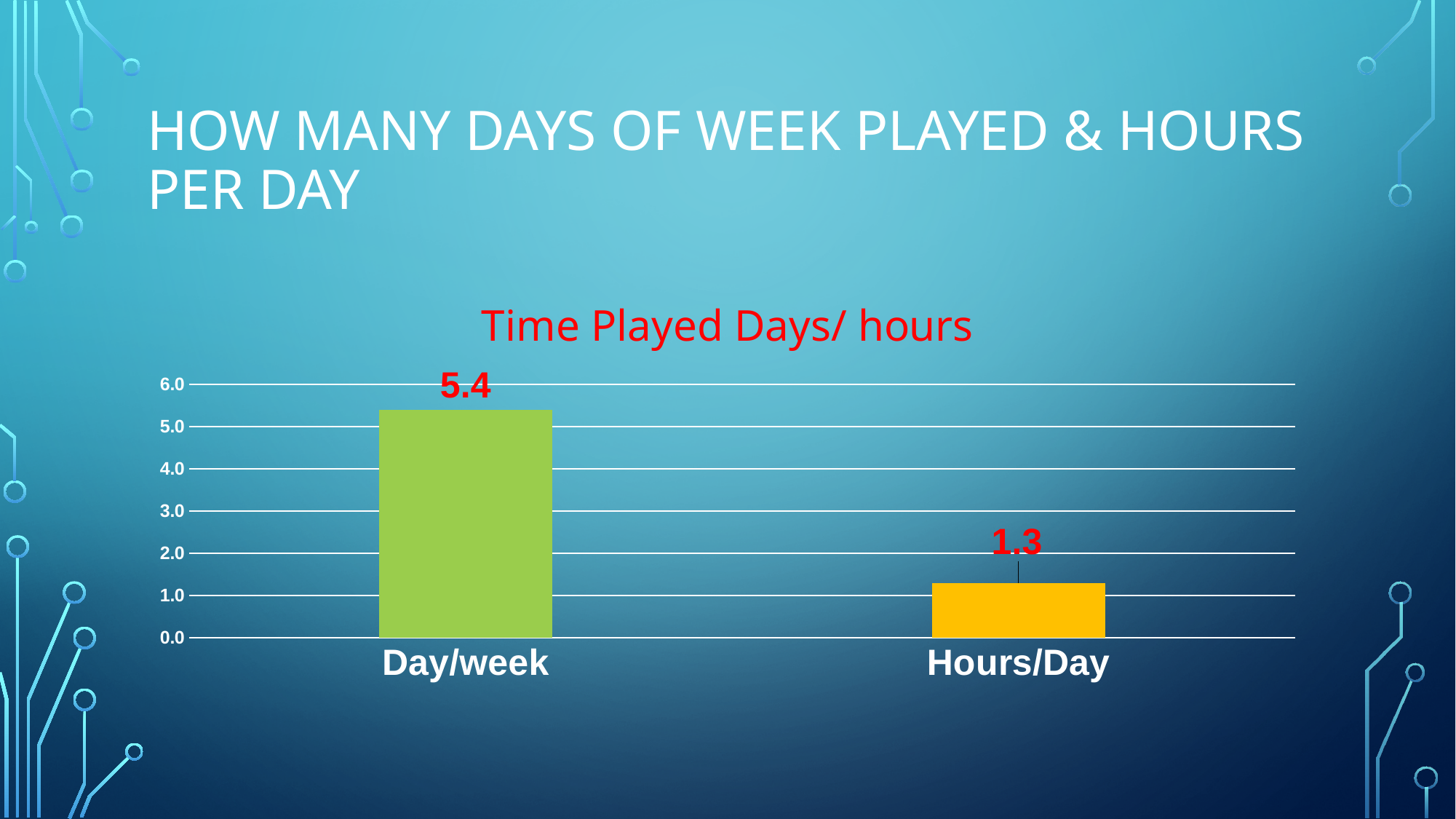
What is the value for Day/week? 5.4 Is the value for Hours/Day greater or less than 2.0? less What is the title of the chart? Time Played Days/ hours Which category has the lowest value? Hours/Day Which category has the highest value? Day/week Is the value for Day/week greater or less than 5.0? greater What is the value for Hours/Day? 1.3 What colour is the Hours/Day bar? Yellow Which is larger, the value for Day/week or the value for Hours/Day? Day/week How many categories are shown on the chart? 2 What is the difference between the Day/week value and the Hours/Day value? 4.1 What kind of chart is shown on the slide? Bar chart